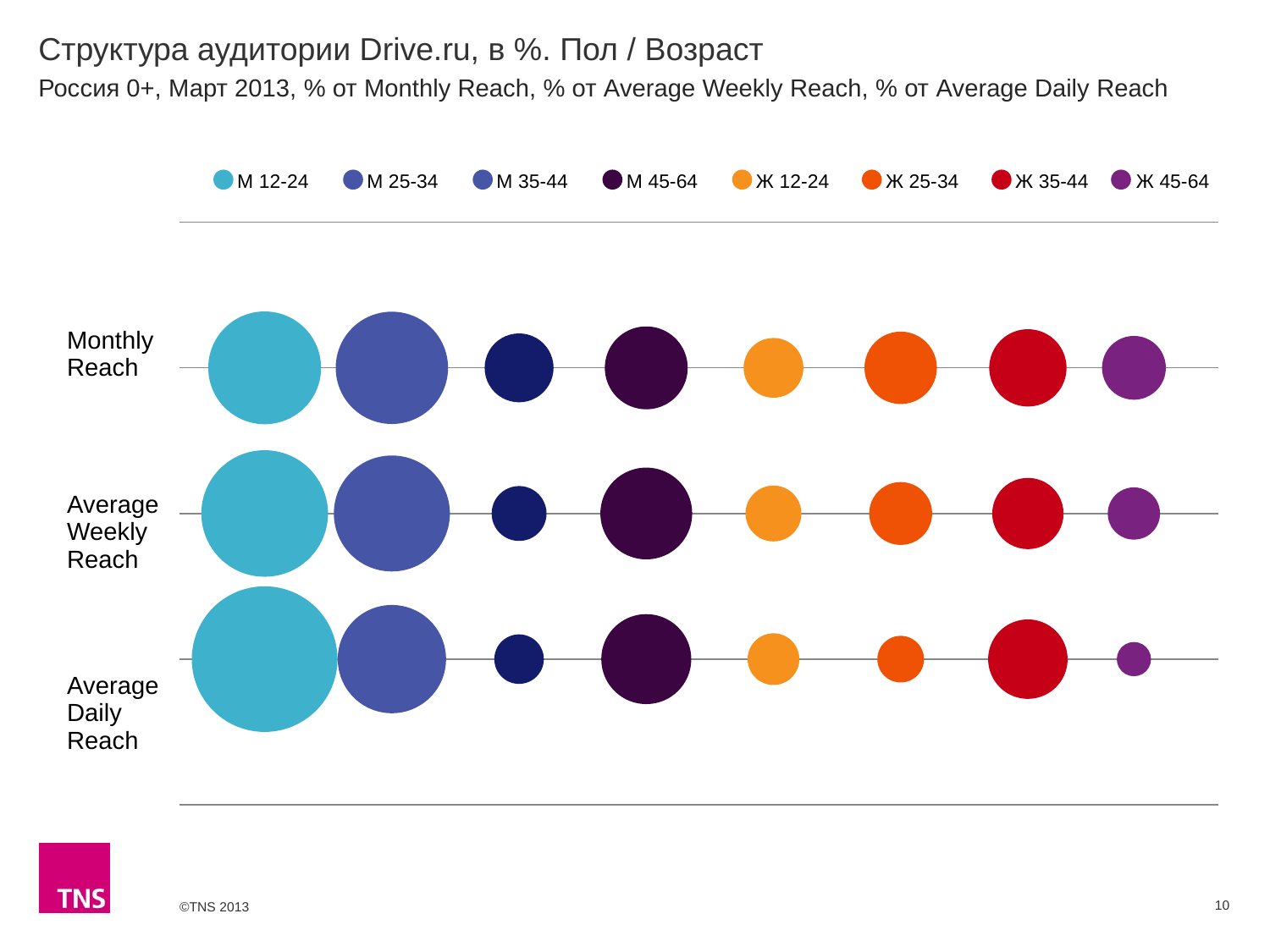
In the Average Daily Reach row, which series has the smallest bubble? Ж 45-64 What kind of chart is shown on the slide? bubble chart How many series does the legend list? 8 Does the Ж 45-64 bubble get larger or smaller going from Monthly Reach to Average Daily Reach? smaller Does the М 12-24 bubble get larger or smaller going from Monthly Reach to Average Daily Reach? larger In the Monthly Reach row, which bubble is larger: М 12-24 or Ж 45-64? М 12-24 In the Average Daily Reach row, which series has the largest bubble? М 12-24 In the Average Daily Reach row, which bubble is larger: М 45-64 or Ж 25-34? М 45-64 How many reach categories (rows) are plotted on the chart? 3 Which website's audience structure does the chart title refer to? Drive.ru In the Average Weekly Reach row, which bubble is larger: М 25-34 or М 35-44? М 25-34